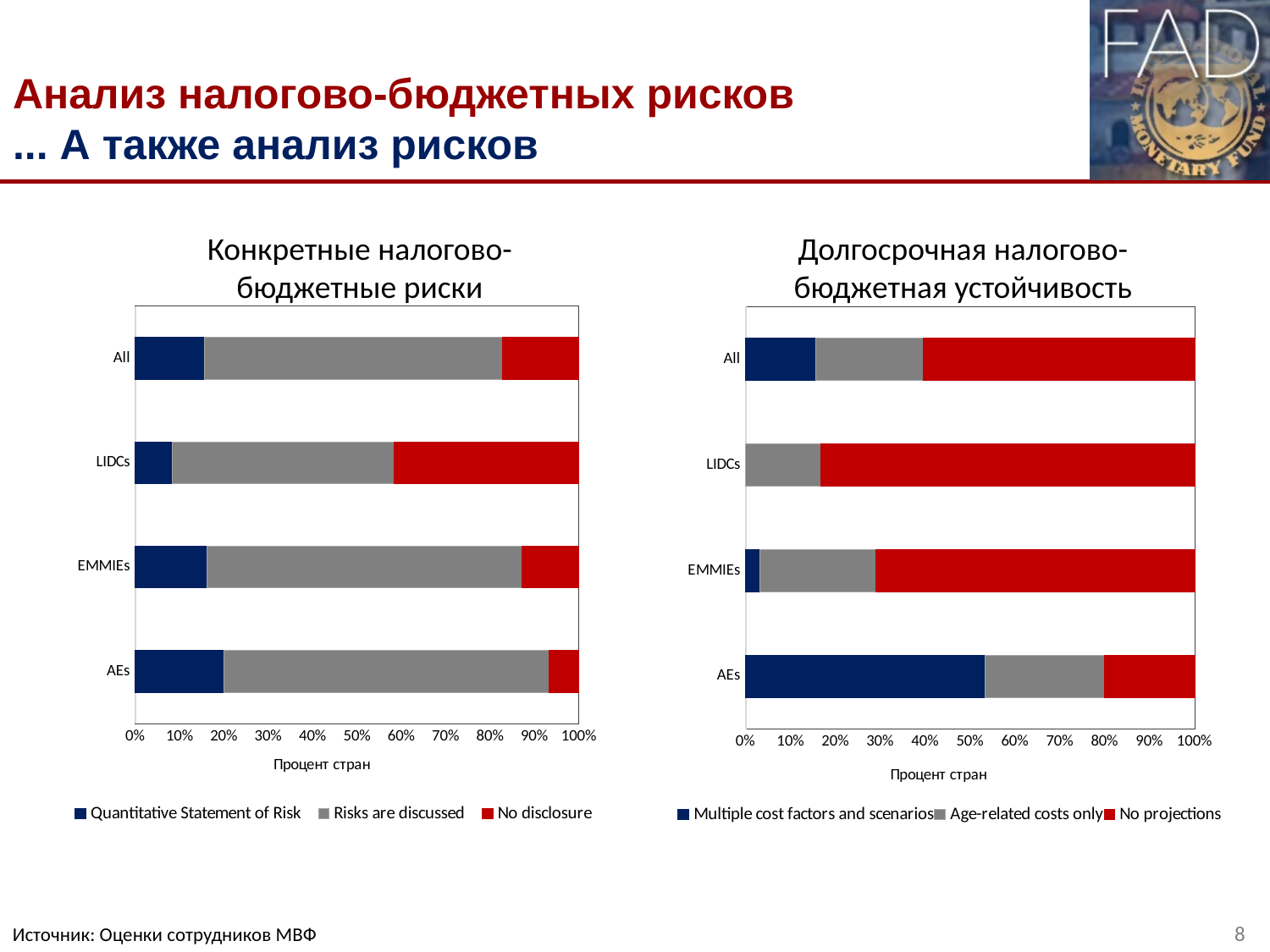
How many series does the legend of the right chart "Долгосрочная налогово-бюджетная устойчивость" list? 3 What is the x-axis label of the left chart "Конкретные налогово-бюджетные риски"? Процент стран How many series does the legend of the left chart "Конкретные налогово-бюджетные риски" list? 3 In the right chart "Долгосрочная налогово-бюджетная устойчивость", which category has the largest "Multiple cost factors and scenarios" segment? AEs In the left chart "Конкретные налогово-бюджетные риски", which category has the smallest "Quantitative Statement of Risk" segment? LIDCs In the left chart "Конкретные налогово-бюджетные риски", is the "Quantitative Statement of Risk" share for LIDCs greater or less than 10%? less In the right chart "Долгосрочная налогово-бюджетная устойчивость", is the "No projections" segment larger for LIDCs or for AEs? LIDCs In the left chart "Конкретные налогово-бюджетные риски", which category has the largest "No disclosure" segment? LIDCs How many categories are shown on the y axis of the left chart "Конкретные налогово-бюджетные риски"? 4 In the right chart "Долгосрочная налогово-бюджетная устойчивость", which legend entry is shown in red? No projections In the right chart "Долгосрочная налогово-бюджетная устойчивость", is the "Multiple cost factors and scenarios" share for AEs greater or less than 40%? greater What kind of chart is the left chart titled "Конкретные налогово-бюджетные риски"? Stacked bar chart